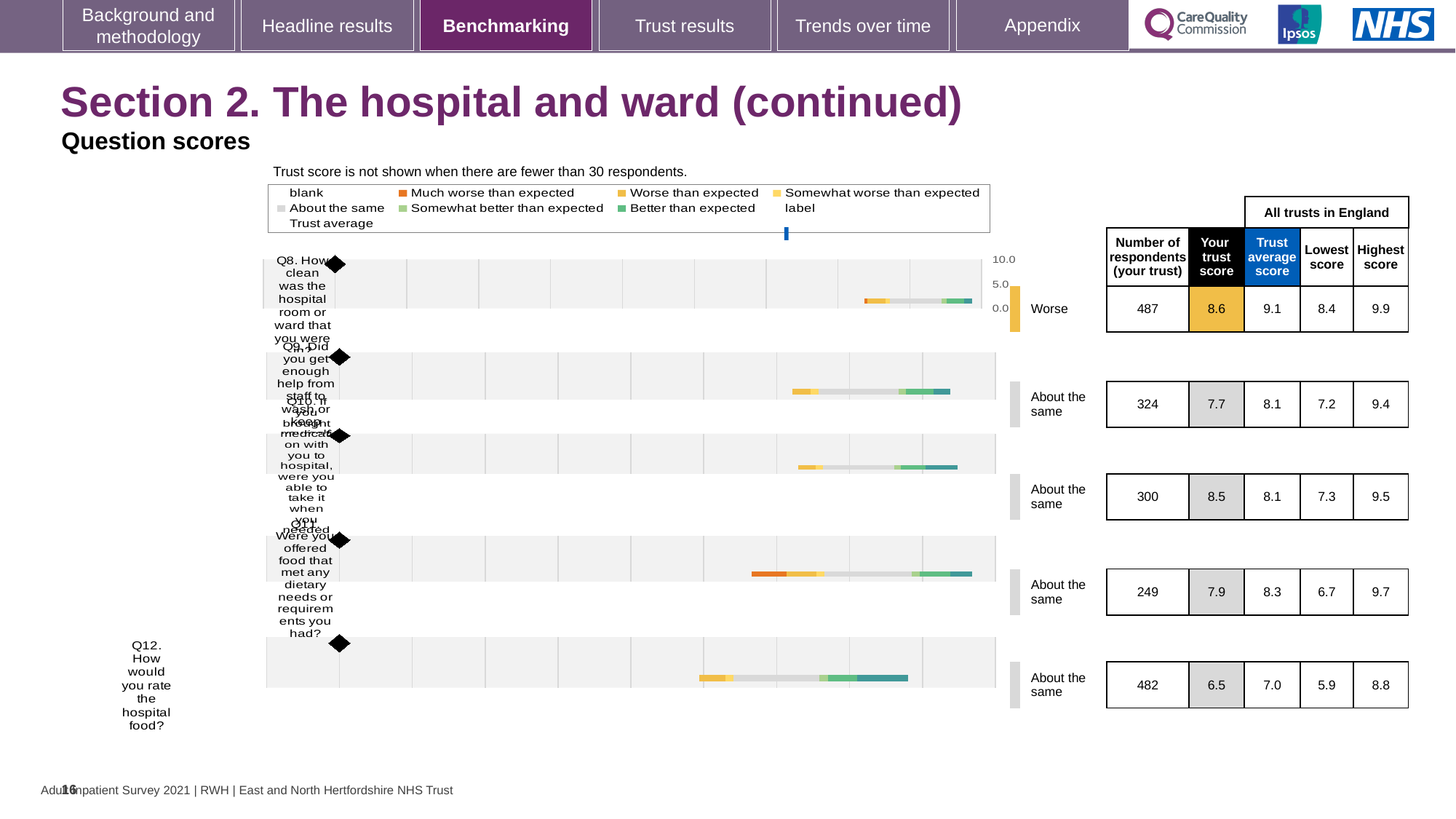
What is the trust score for Q8 (how clean was the hospital room or ward)? 8.6 How many questions are plotted on the chart? 5 Which question has the lowest trust score? Q12 Which question has the highest trust score? Q8 Which question has the most respondents? Q8 For Q10, which is larger: the trust score or the trust average score? Trust score (8.5) How many respondents answered Q12 (how would you rate the hospital food)? 482 Which question is rated 'Worse' compared with other trusts? Q8 What is the difference between the trust average score and the trust score for Q8? 0.5 What is the lowest score across all trusts in England for Q11? 6.7 What is the highest score across all trusts in England for Q12? 8.8 What kind of chart is used to show the question scores? Bar chart